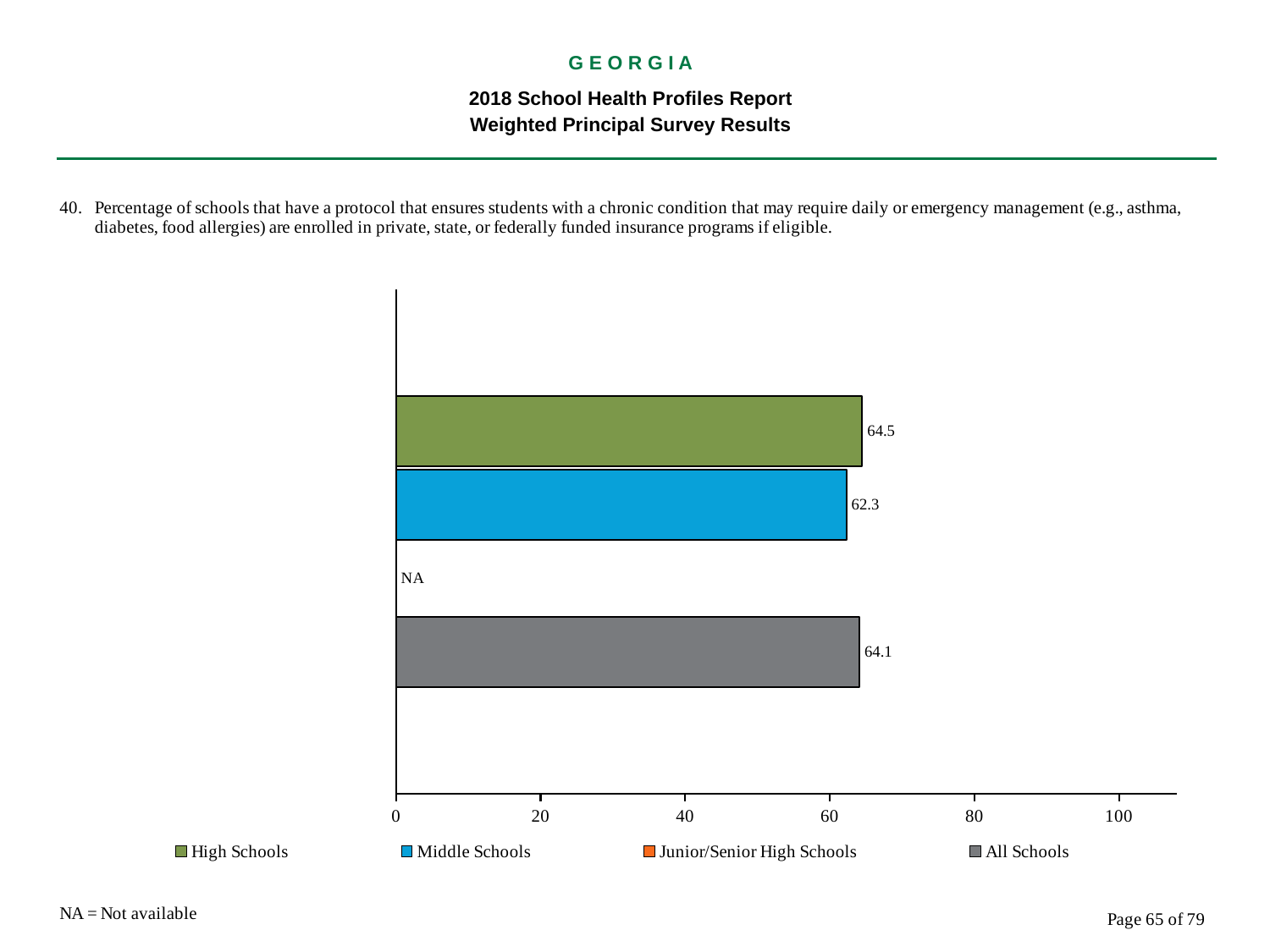
What is the value for High Schools? 64.5 How many series does the legend list? 4 What is the value for All Schools? 64.1 What kind of chart is shown? bar chart What does NA stand for according to the note on the slide? Not available What is shown for Junior/Senior High Schools? NA What is the difference between the All Schools and Middle Schools values? 1.8 What is the difference between the High Schools and Middle Schools values? 2.2 What is the value for Middle Schools? 62.3 Is the value for Middle Schools greater or less than 60? greater Which school type with a plotted value has the lowest value? Middle Schools Which school type has the highest value? High Schools